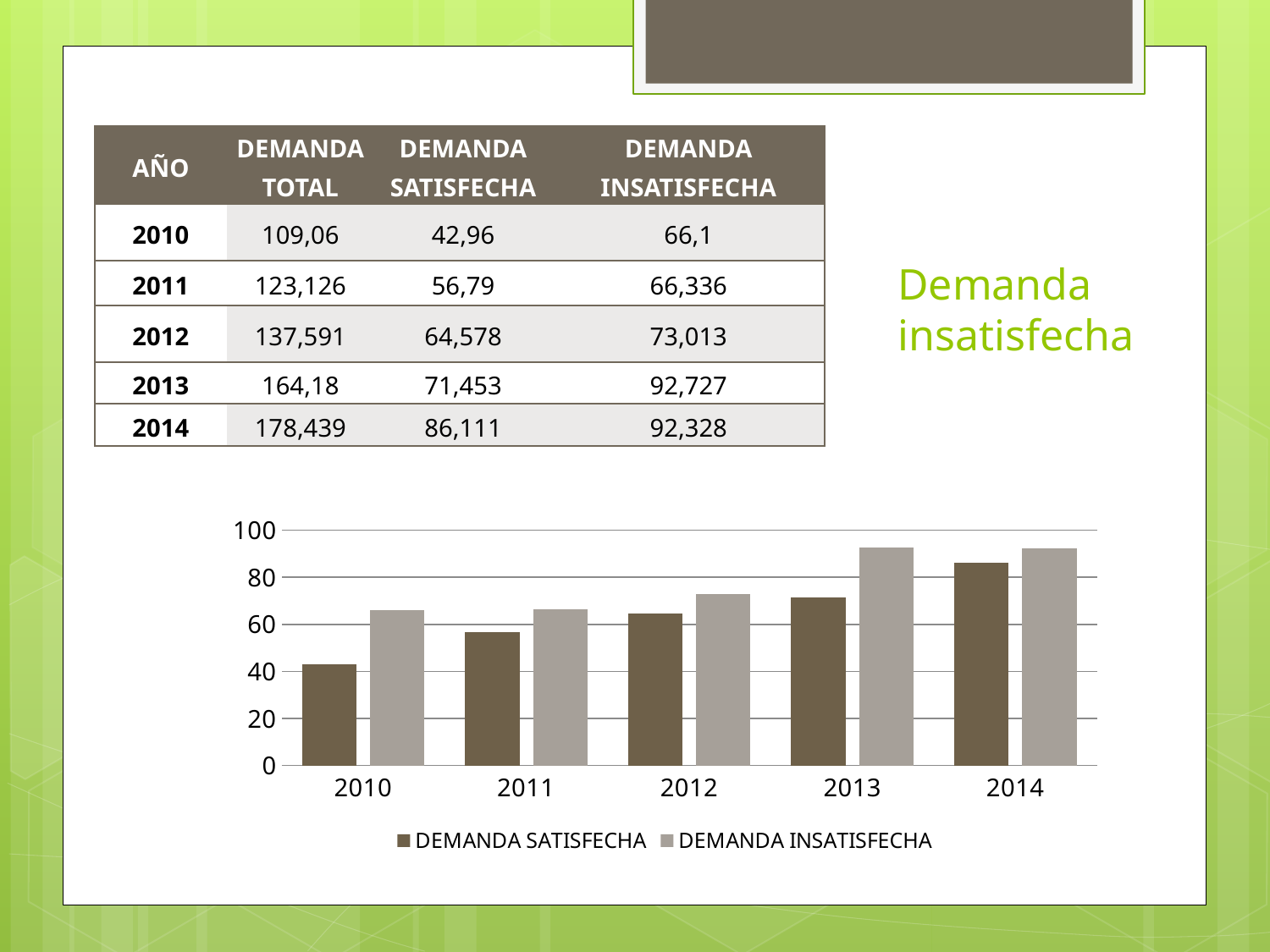
What kind of chart is shown on the slide? bar chart Is the DEMANDA SATISFECHA value for 2010 greater or less than 60? less According to the table, what is the difference between DEMANDA INSATISFECHA and DEMANDA SATISFECHA in 2014? 6,217 Does DEMANDA SATISFECHA rise or fall from 2010 to 2014? rises Which year has the highest DEMANDA SATISFECHA bar? 2014 What are the two entries in the chart legend? DEMANDA SATISFECHA and DEMANDA INSATISFECHA According to the table, what is the DEMANDA INSATISFECHA value for 2012? 73,013 In 2012, which is larger: DEMANDA SATISFECHA or DEMANDA INSATISFECHA? DEMANDA INSATISFECHA How many years are shown on the x axis of the chart? 5 Which year has the lowest DEMANDA SATISFECHA bar? 2010 Is the DEMANDA INSATISFECHA value for 2013 greater or less than 80? greater How many series does the chart legend list? 2